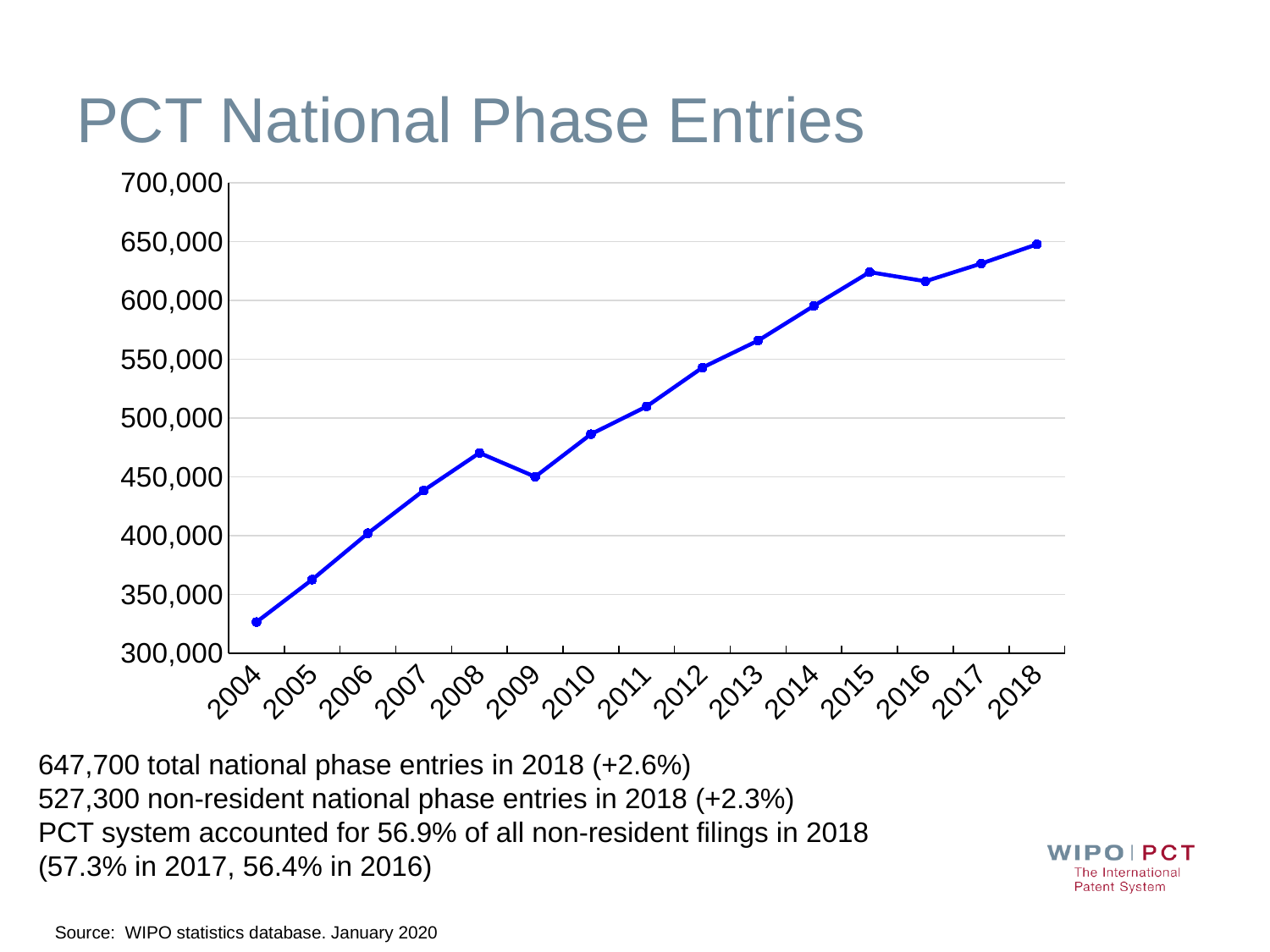
Overall, do PCT national phase entries rise or fall from 2004 to 2018? rise Is the value for 2004 greater or less than 350,000? less Is the value for 2013 greater or less than 550,000? greater How many years are plotted on the x axis of the chart? 15 Is the value for 2010 greater or less than 500,000? less What kind of chart is shown on the slide? line chart What is the title of the chart? PCT National Phase Entries Which year has the lowest number of PCT national phase entries? 2004 Which year has more national phase entries, 2015 or 2016? 2015 Which year has the highest number of PCT national phase entries? 2018 Which year has more national phase entries, 2008 or 2009? 2008 What is the total number of national phase entries in 2018? 647,700